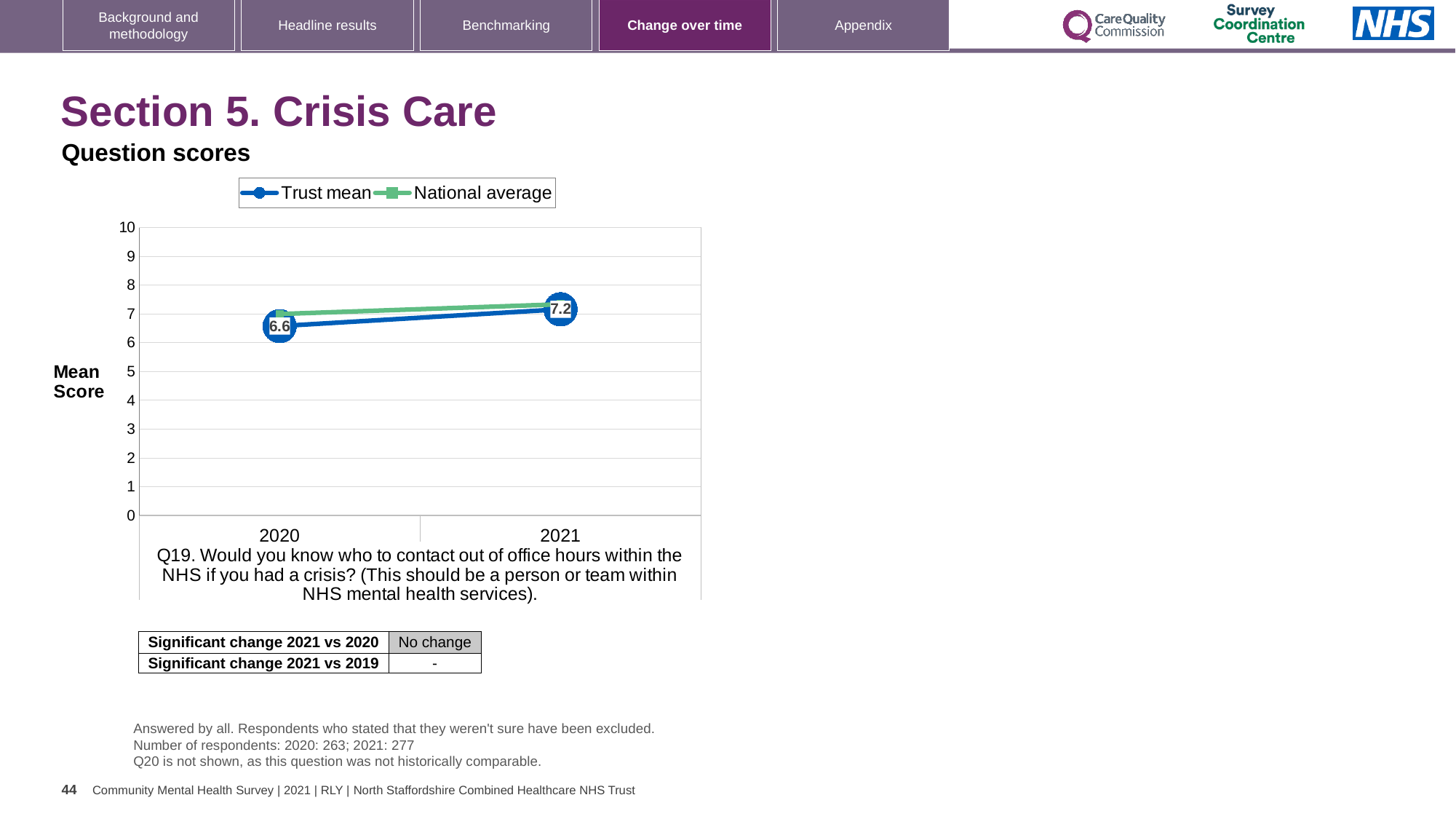
Which year has the higher Trust mean score, 2020 or 2021? 2021 How many years are plotted on the x axis? 2 Does the Trust mean rise or fall from 2020 to 2021? rise In 2020, which is higher, the Trust mean or the National average? National average What kind of chart is shown on the slide? line chart What is the Trust mean score for 2021? 7.2 By how much did the Trust mean score change from 2020 to 2021? 0.6 Is the National average value for 2021 greater or less than 5? greater What is the Trust mean score for 2020? 6.6 What is the label on the y axis of the chart? Mean Score Is the Trust mean value for 2020 greater or less than 7? less How many series does the legend list? 2